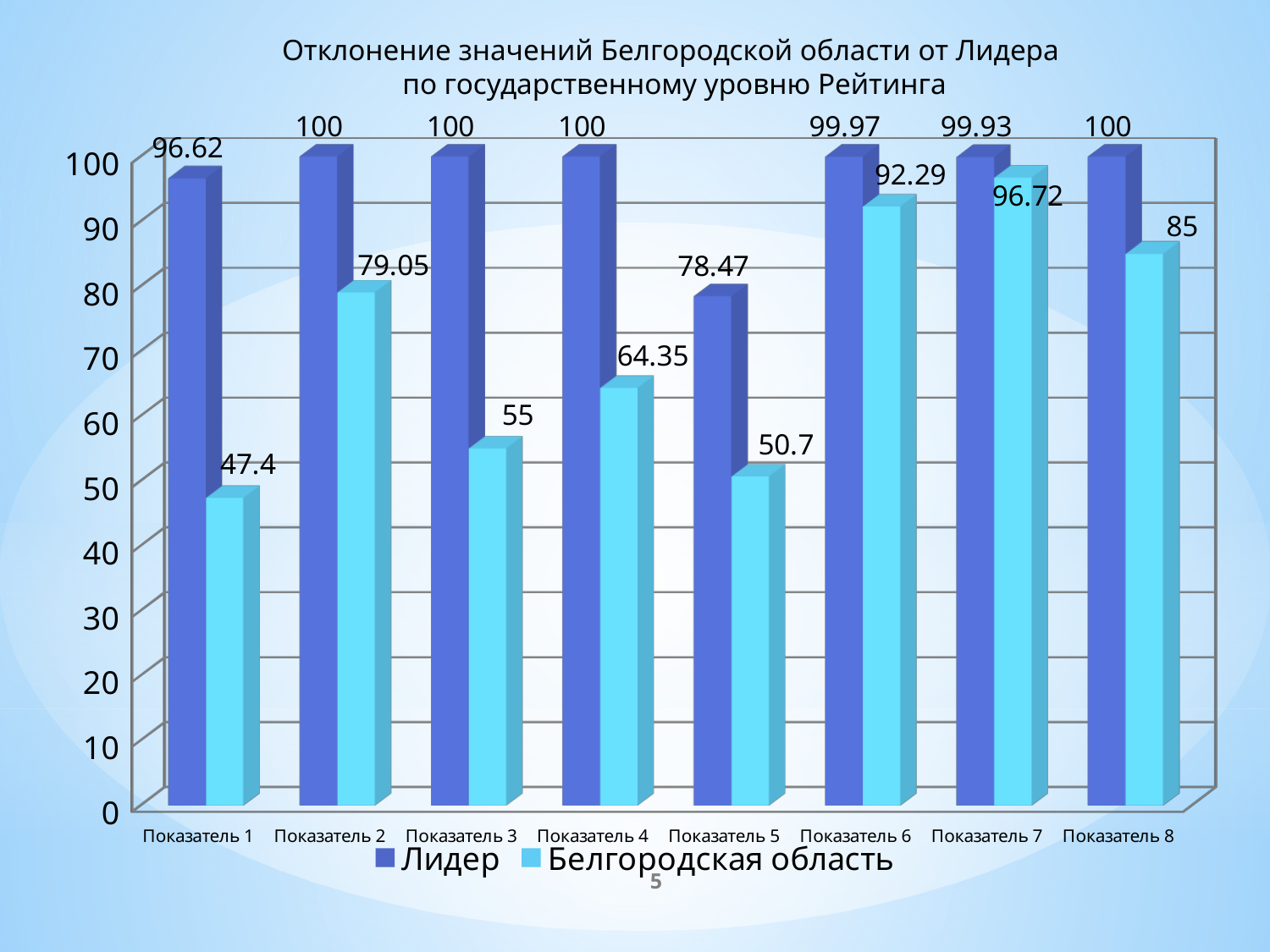
How many series does the legend list? 2 For which category is the Белгородская область value the lowest? Показатель 1 What is the difference between the Лидер and Белгородская область values for Показатель 3? 45 What is the value for Белгородская область for Показатель 1? 47.4 For which category is the Белгородская область value the highest? Показатель 7 Which is larger: the Белгородская область value for Показатель 2 or for Показатель 4? Показатель 2 What is the value for Лидер for Показатель 5? 78.47 What type of chart is shown on the slide? Bar chart For which category is the Лидер value the lowest? Показатель 5 Which series is shown in dark blue in the legend? Лидер How many categories (показатели) are shown on the x axis? 8 What is the value for Белгородская область for Показатель 6? 92.29